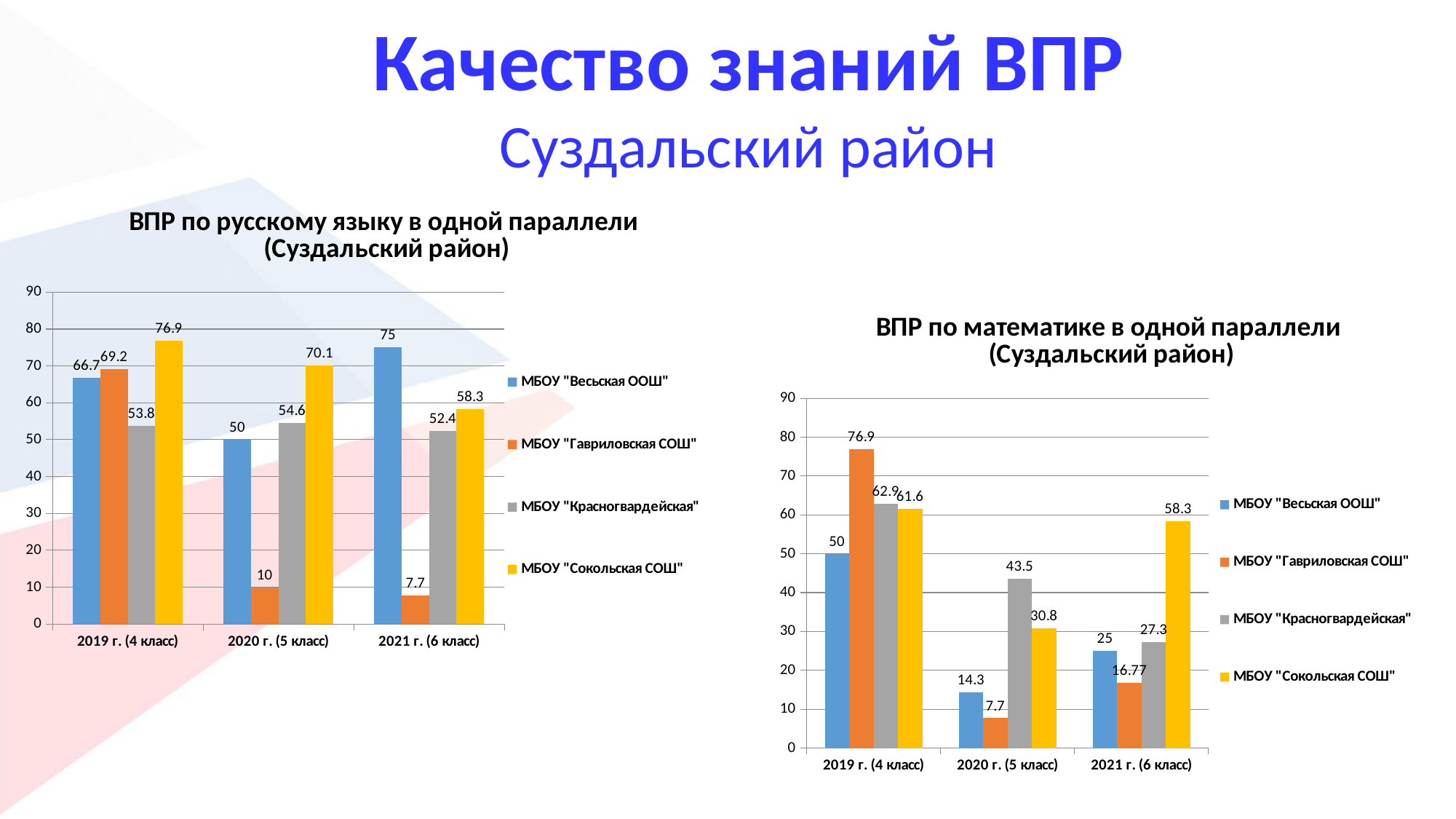
In the chart "ВПР по математике в одной параллели", what is the value for МБОУ "Гавриловская СОШ" in 2021 г. (6 класс)? 16.77 In the chart "ВПР по русскому языку в одной параллели", what is the value for МБОУ "Сокольская СОШ" in 2019 г. (4 класс)? 76.9 In the chart "ВПР по русскому языку в одной параллели", what is the difference between МБОУ "Сокольская СОШ" and МБОУ "Гавриловская СОШ" in 2020 г. (5 класс)? 60.1 In the chart "ВПР по русскому языку в одной параллели", which school has the highest value in 2021 г. (6 класс)? МБОУ "Весьская ООШ" In the chart "ВПР по математике в одной параллели", which school has the lowest value in 2020 г. (5 класс)? МБОУ "Гавриловская СОШ" In the chart "ВПР по математике в одной параллели", what is the value for МБОУ "Красногвардейская" in 2020 г. (5 класс)? 43.5 In the chart "ВПР по математике в одной параллели", which is larger in 2019 г. (4 класс): МБОУ "Весьская ООШ" or МБОУ "Гавриловская СОШ"? МБОУ "Гавриловская СОШ" In the chart "ВПР по математике в одной параллели", what is the difference between МБОУ "Сокольская СОШ" and МБОУ "Весьская ООШ" in 2021 г. (6 класс)? 33.3 What kind of chart is "ВПР по русскому языку в одной параллели"? Bar chart How many series does the legend of the chart "ВПР по математике в одной параллели" list? 4 In the chart "ВПР по русскому языку в одной параллели", how do the values for МБОУ "Гавриловская СОШ" change from 2019 to 2021? They fall In the chart "ВПР по русскому языку в одной параллели", what is the value for МБОУ "Гавриловская СОШ" in 2021 г. (6 класс)? 7.7